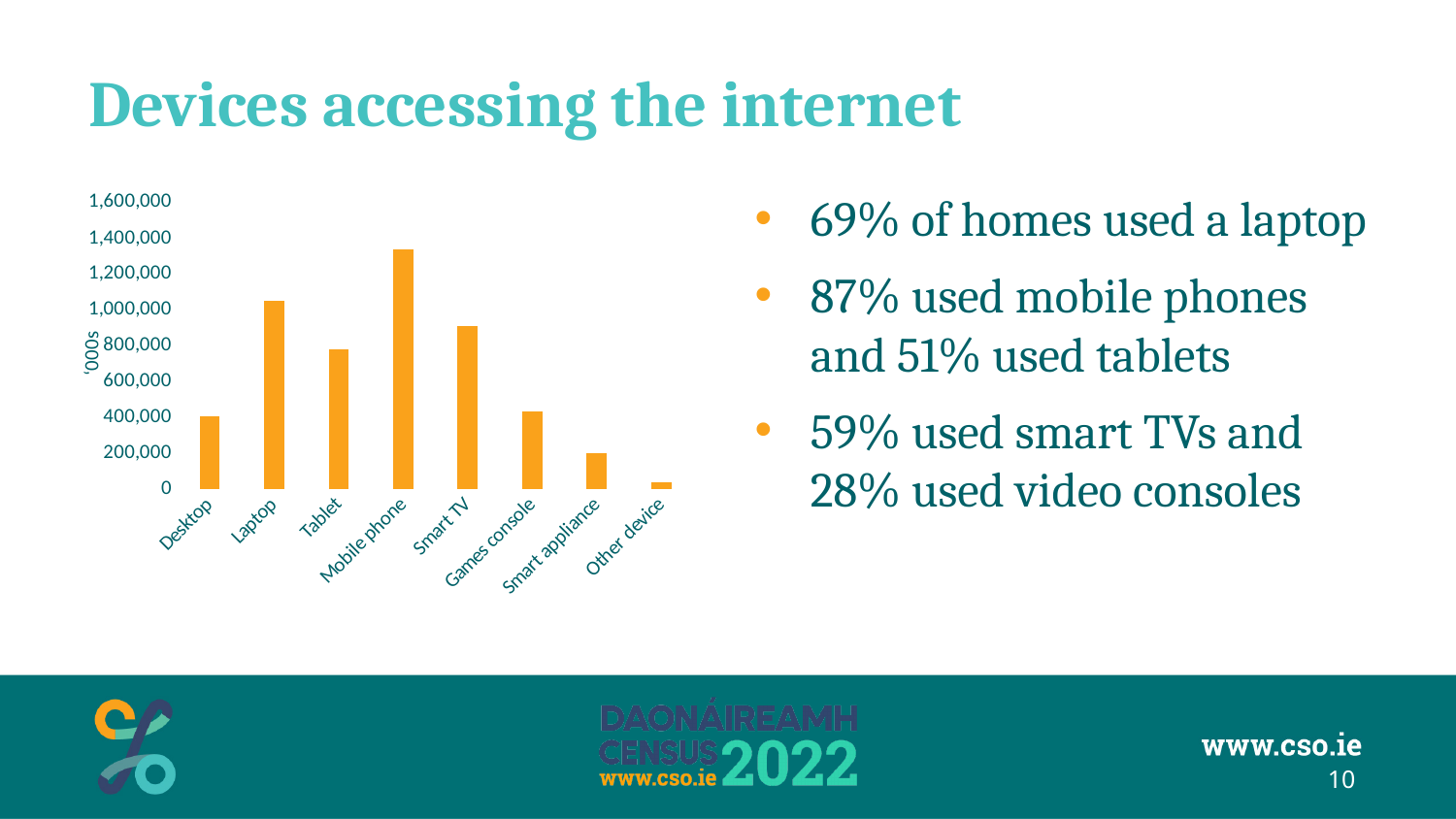
Is the value for Smart TV greater or less than 1,000,000? less What unit label is shown on the y axis of the chart? '000s Is the value for Mobile phone greater or less than 1,200,000? greater Which is larger, the value for Laptop or the value for Smart TV? Laptop What kind of chart is shown on the slide? bar chart Which device category has the lowest bar in the chart? Other device Is the value for Other device greater or less than 200,000? less Which is larger, the value for Tablet or the value for Games console? Tablet Which device category has the highest bar in the chart? Mobile phone How many device categories are shown on the x axis of the chart? 8